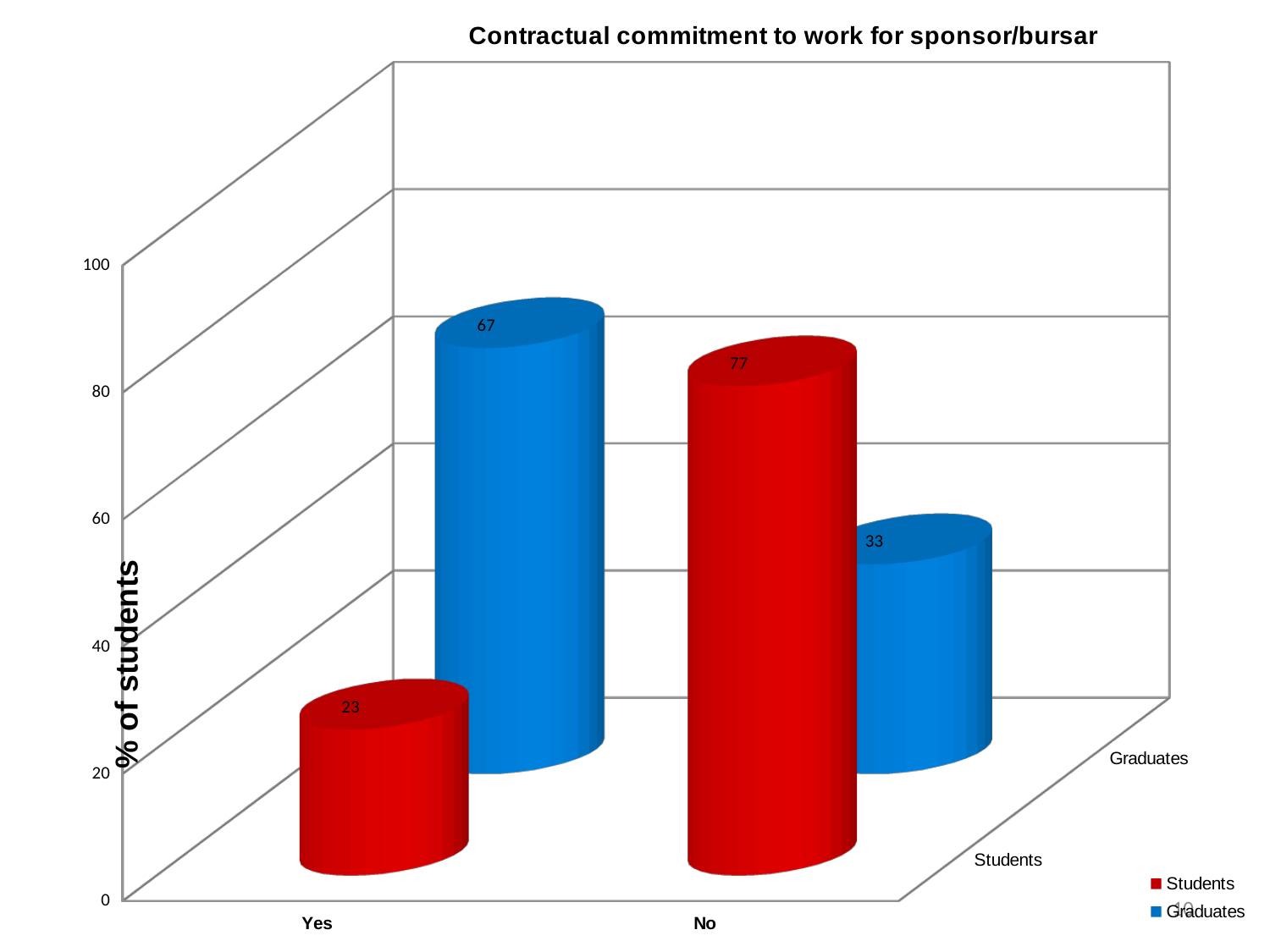
Which category has the highest value for Students? No How many categories are shown on the x axis? 2 What is the difference between the Students values for No and Yes? 54 Which is larger in the Yes category, Students or Graduates? Graduates What is the value for Graduates in the Yes category? 67 How many series does the legend list? 2 What is the value for Students in the No category? 77 Which category has the lowest value for Graduates? No What is the title of the chart? Contractual commitment to work for sponsor/bursar What kind of chart is shown? Bar chart What is the value for Graduates in the No category? 33 What is the value for Students in the Yes category? 23